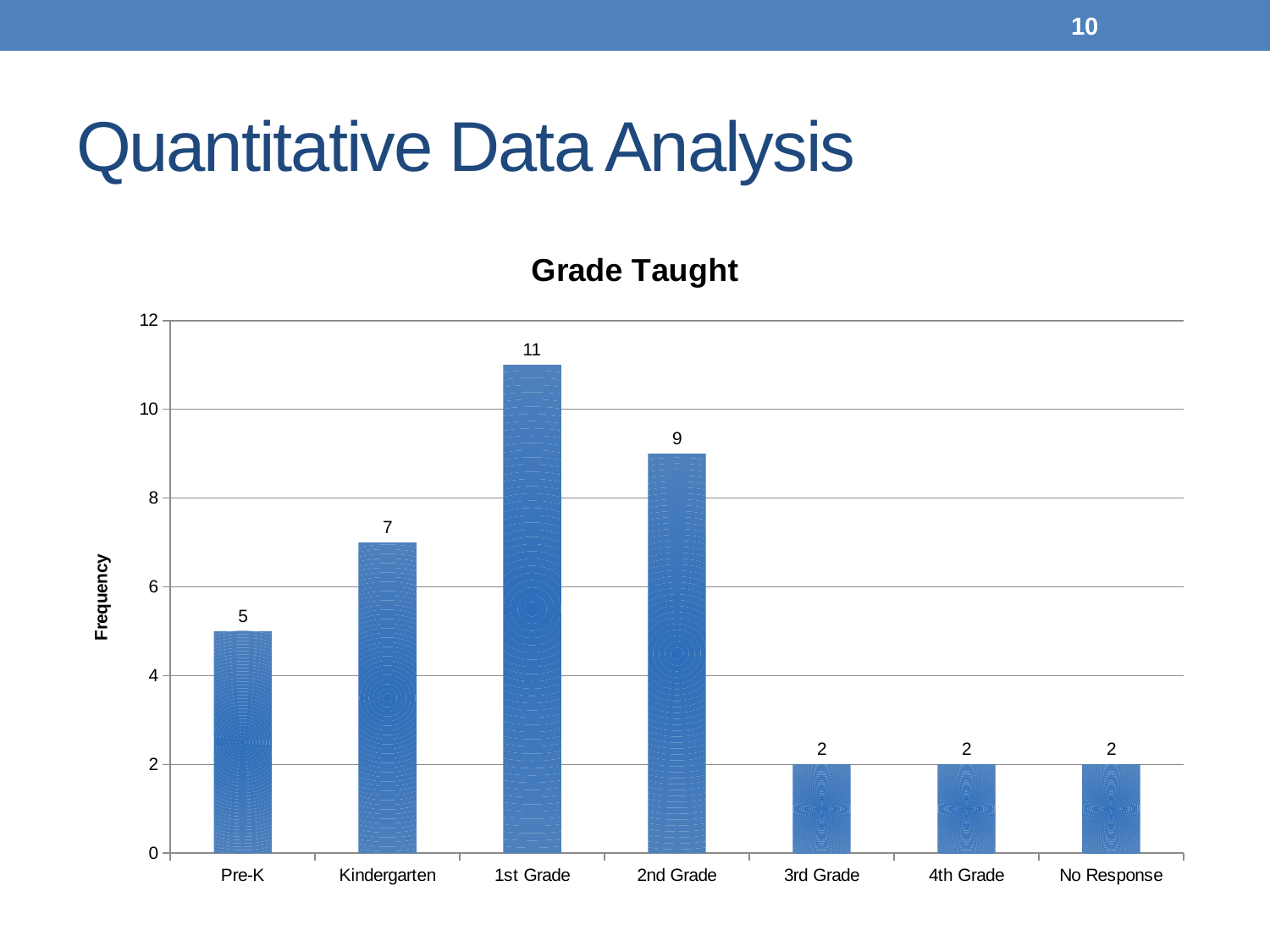
Is the frequency for 2nd Grade greater or less than 8? greater What kind of chart is shown on the slide? bar chart What is the title of the chart? Grade Taught Which grade has the highest frequency? 1st Grade What is the difference in frequency between 1st Grade and 2nd Grade? 2 What is the frequency for Kindergarten? 7 What is the frequency for Pre-K? 5 Which has a higher frequency, Pre-K or 2nd Grade? 2nd Grade How many categories are shown on the x axis? 7 What is the label of the vertical axis? Frequency What is the difference in frequency between Kindergarten and Pre-K? 2 What is the frequency for 1st Grade? 11